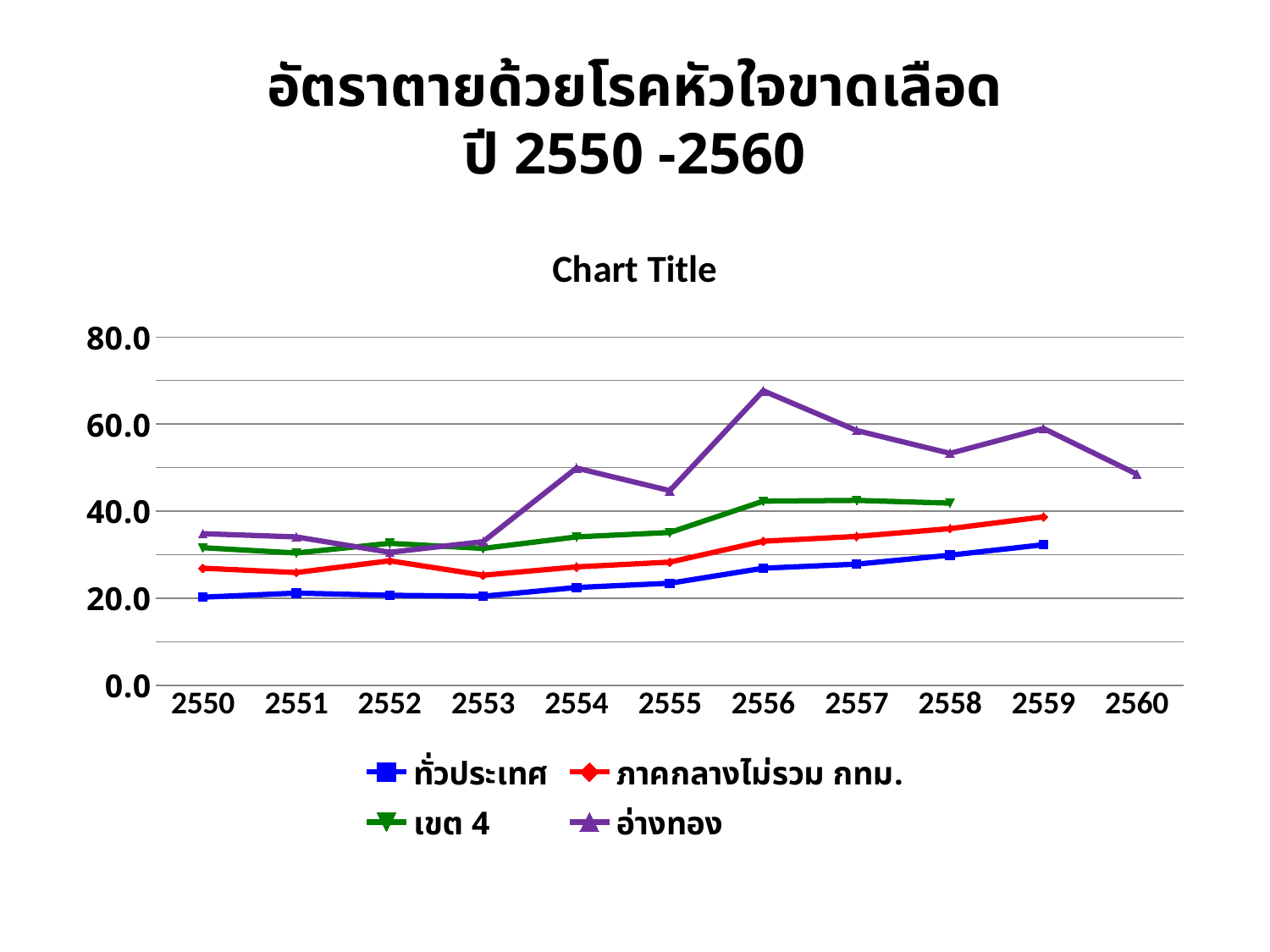
How many years are shown on the x axis? 11 How many series does the legend list? 4 Is the value for ภาคกลางไม่รวม กทม. in 2553 greater or less than 20? greater What colour is the line for เขต 4? green Is the value for อ่างทอง in 2556 greater or less than 60? greater What kind of chart is shown on the slide? line chart Does the ทั่วประเทศ series generally rise or fall from 2550 to 2559? rise In which year does the ทั่วประเทศ series reach its highest value? 2559 In 2556, which is larger: the value for อ่างทอง or the value for ทั่วประเทศ? อ่างทอง Is the value for ทั่วประเทศ in 2559 greater or less than 40? less In which year does the อ่างทอง series reach its highest value? 2556